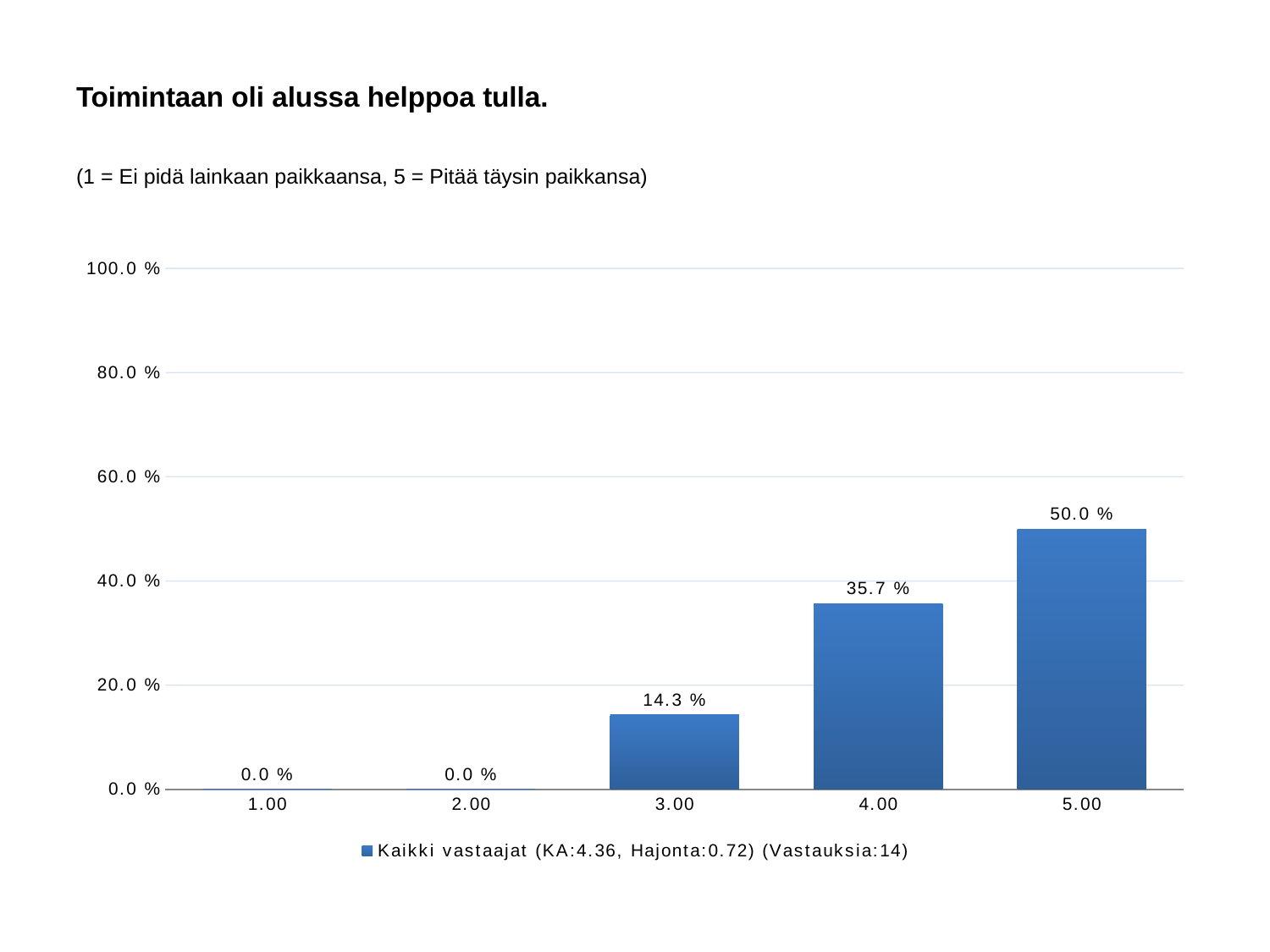
What kind of chart is shown on the slide? bar chart What is the value for category 5.00? 50.0 % Which is larger, the value for 3.00 or the value for 4.00? 4.00 What is the value for category 3.00? 14.3 % Do the values rise or fall from category 1.00 to category 5.00? rise What is the value for category 4.00? 35.7 % Is the value for 5.00 greater or less than 40.0 %? greater What is the difference between the values for 5.00 and 4.00? 14.3 % What is the value for category 1.00? 0.0 % How many categories are shown on the x axis? 5 Which category has the highest value? 5.00 What is the difference between the values for 4.00 and 3.00? 21.4 %